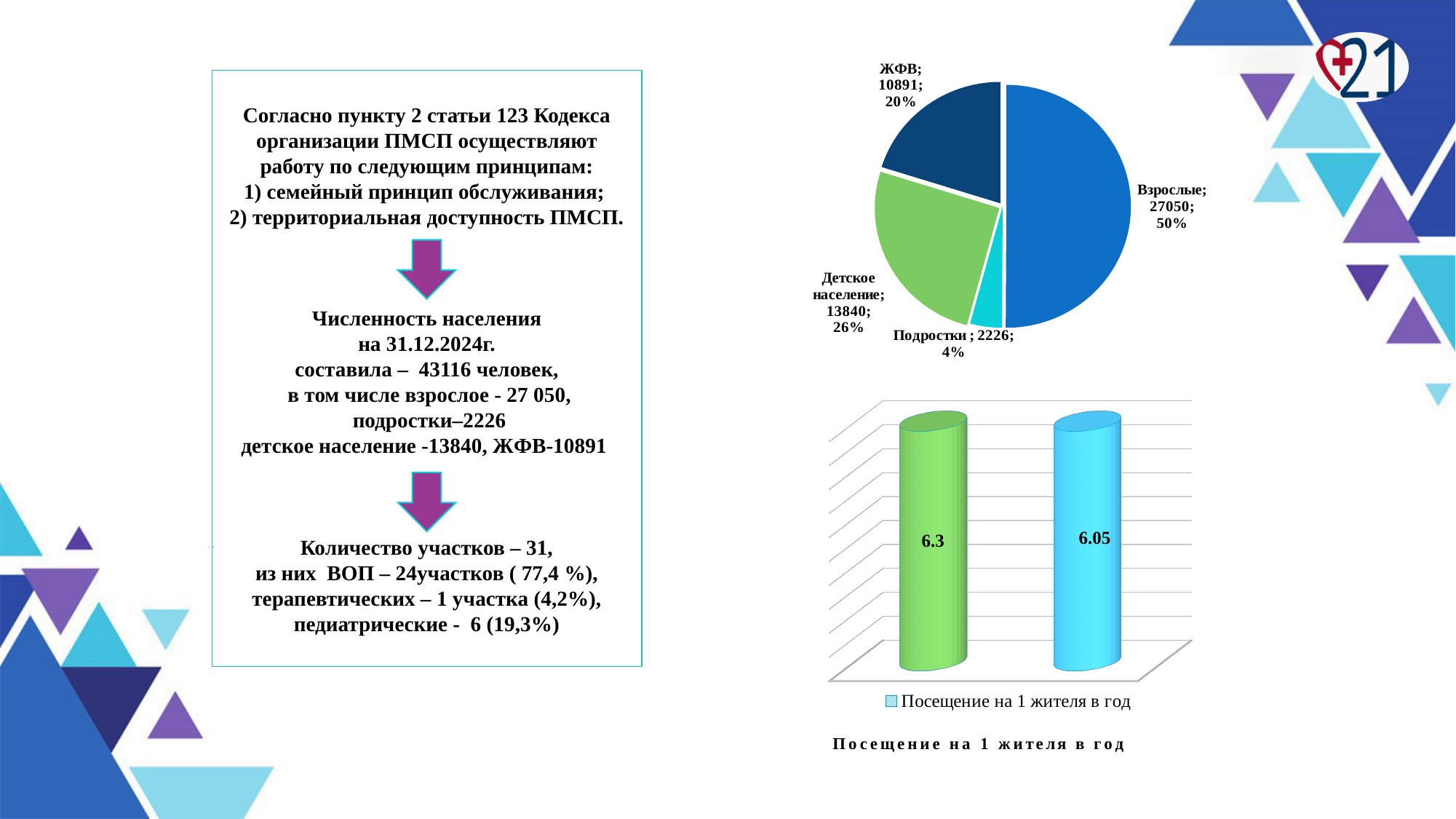
In the pie chart, what value is shown for Взрослые? 27050 In the pie chart, what percentage share does Подростки have? 4% In the pie chart, which category has the smallest slice? Подростки In the pie chart, what value is shown for ЖФВ? 10891 What kind of chart is the one titled Посещение на 1 жителя в год? Bar chart In the pie chart, what percentage share does Детское население have? 26% In the chart titled Посещение на 1 жителя в год, what is the value of the left (green) bar? 6.3 In the chart titled Посещение на 1 жителя в год, what is the difference between the two bars? 0.25 In the pie chart, how many categories are shown? 4 In the chart titled Посещение на 1 жителя в год, what is the value of the right (blue) bar? 6.05 In the pie chart, what is the difference between the values for Взрослые and Детское население? 13210 In the pie chart, which category has the largest slice? Взрослые